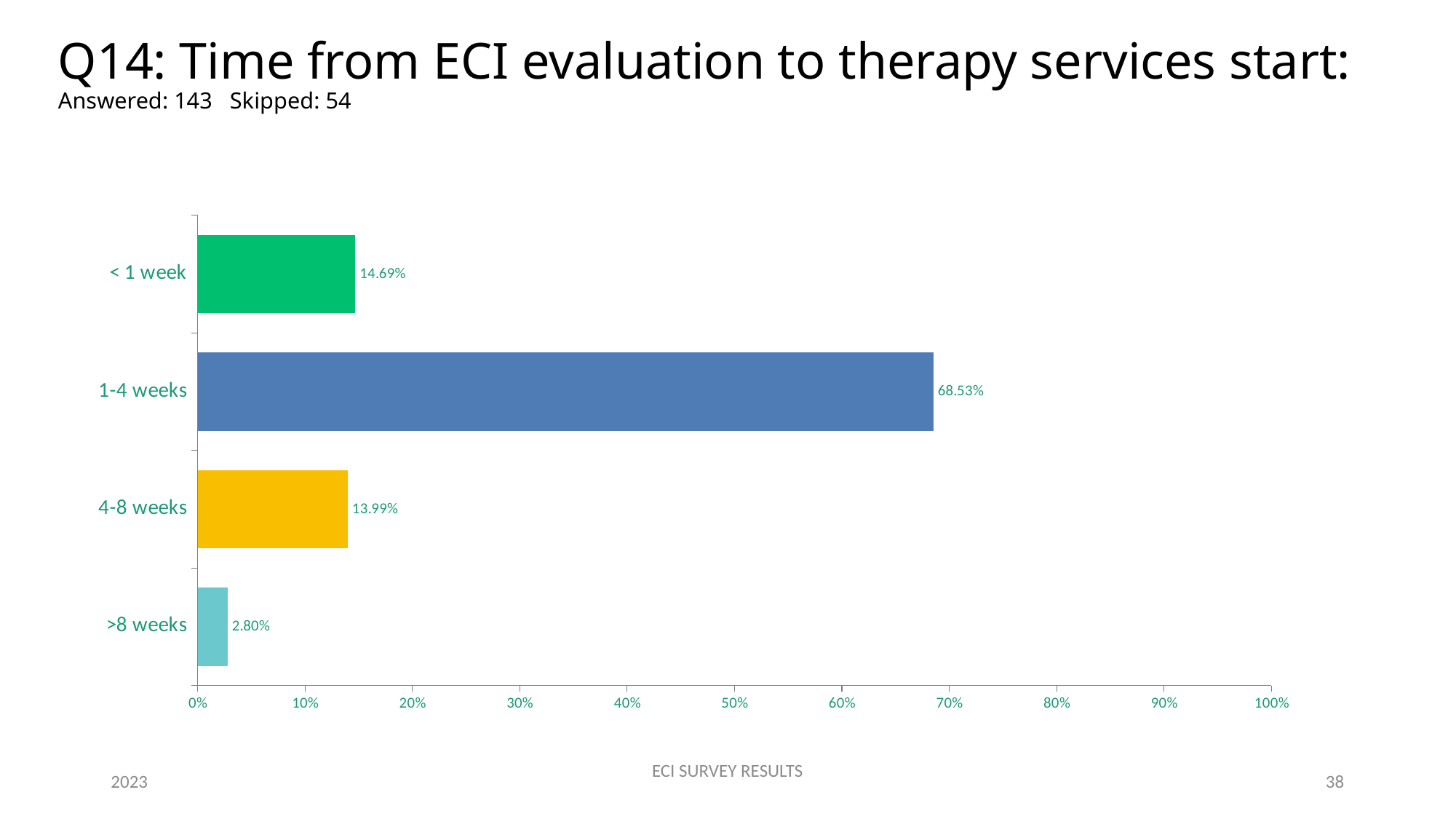
What percentage of respondents reported a time of 1-4 weeks from ECI evaluation to therapy services start? 68.53% How many respondents answered this question according to the slide? 143 Which is larger, the value for '< 1 week' or the value for '4-8 weeks'? < 1 week What is the value shown for the '>8 weeks' category? 2.80% How many categories are shown in the chart? 4 What is the difference between the percentages for '1-4 weeks' and '4-8 weeks'? 54.54% Is the value for '1-4 weeks' greater or less than 60%? greater Which category has the lowest percentage? >8 weeks Which category has the highest percentage? 1-4 weeks What type of chart is shown on the slide? bar chart What colour is the bar for '4-8 weeks'? yellow What is the value shown for the '< 1 week' category? 14.69%